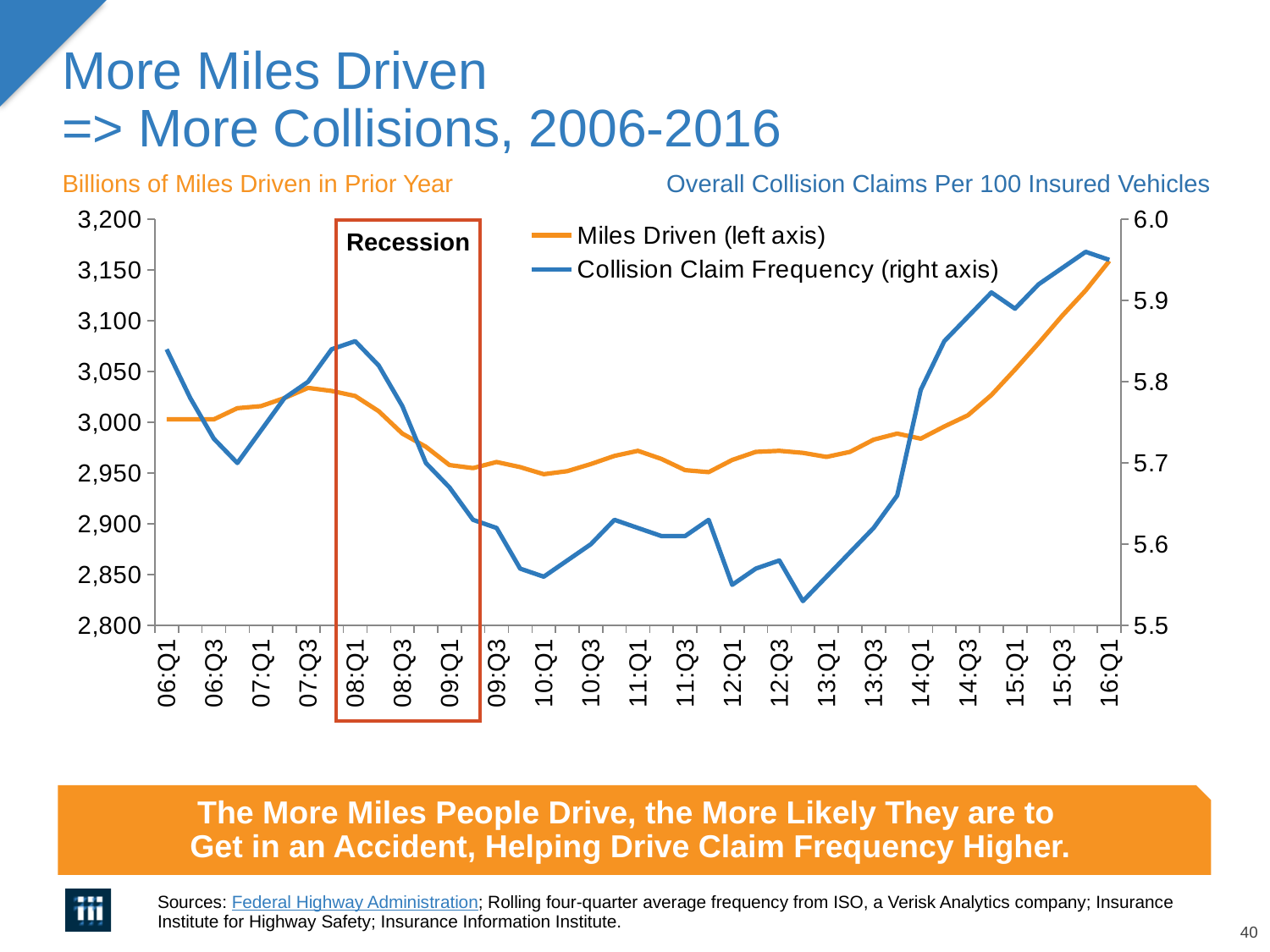
Does Miles Driven rise or fall from 13:Q3 to 16:Q1? rise Is the value for Collision Claim Frequency at 13:Q1 greater or less than 5.6? less What label appears inside the red box on the chart? Recession Is the value for Collision Claim Frequency at 16:Q1 greater or less than 5.9? greater At which x-axis label does Miles Driven reach its highest value? 16:Q1 Which series is plotted against the right axis according to the legend? Collision Claim Frequency Does Collision Claim Frequency rise or fall from 08:Q1 to 09:Q3? fall What kind of chart is shown on the slide? Line chart How many series does the legend list? 2 Is the value for Miles Driven at 16:Q1 greater or less than 3,100? greater